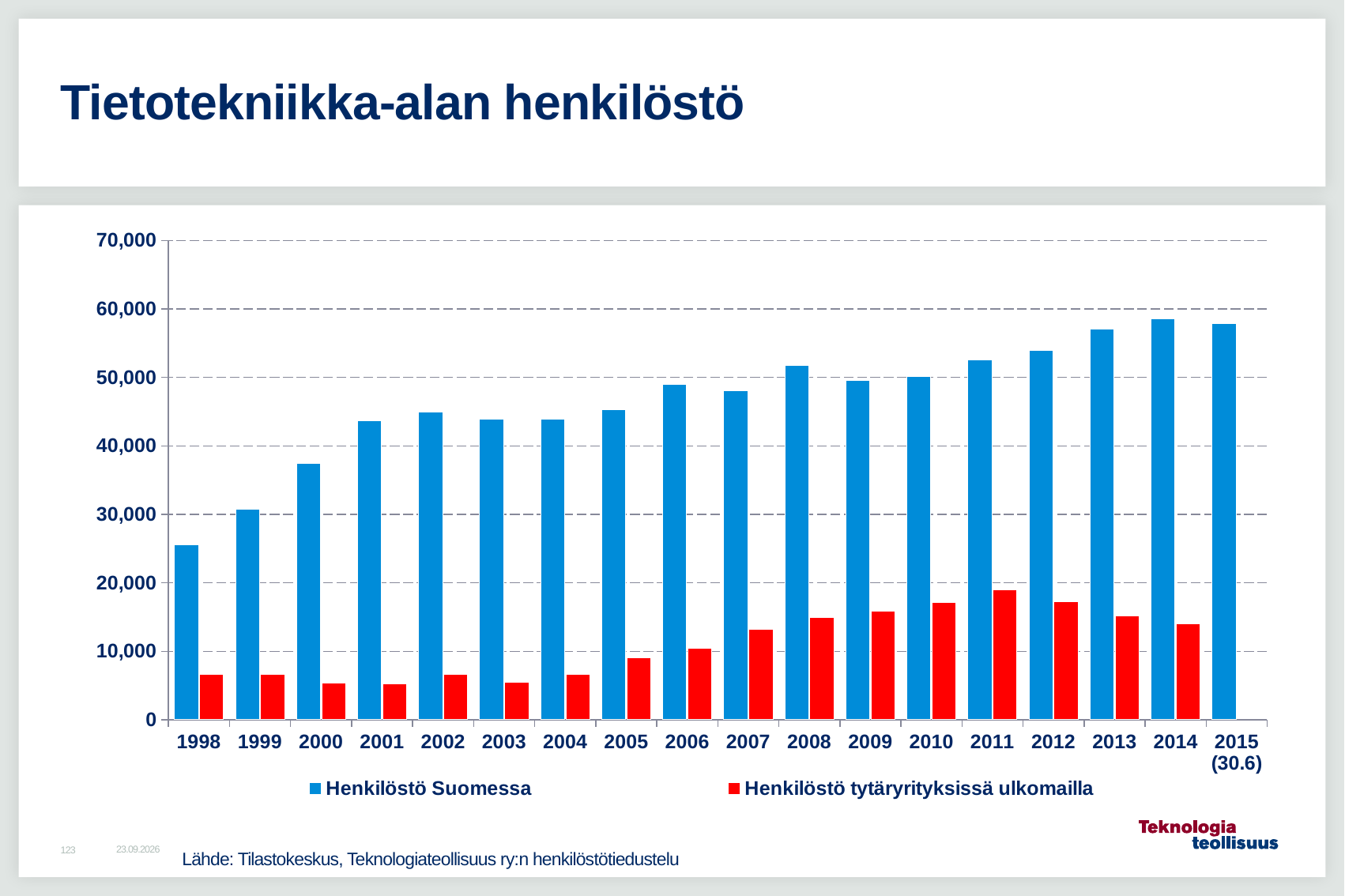
Is the value for Henkilöstö Suomessa in 1998 greater or less than 30,000? less Is the value for Henkilöstö tytäryrityksissä ulkomailla in 2011 greater or less than 20,000? less Which is larger for Henkilöstö tytäryrityksissä ulkomailla: the value in 2012 or in 2014? 2012 What kind of chart is shown on the slide? bar chart Is the value for Henkilöstö Suomessa in 2008 greater or less than 50,000? greater Which is larger for Henkilöstö Suomessa: the value in 2008 or in 2009? 2008 How many series does the legend list? 2 How many years (categories) are shown on the x axis? 18 Which year has the lowest value for Henkilöstö Suomessa? 1998 Does the value for Henkilöstö Suomessa generally rise or fall from 1998 to 2014? rise Which year has the highest value for Henkilöstö tytäryrityksissä ulkomailla? 2011